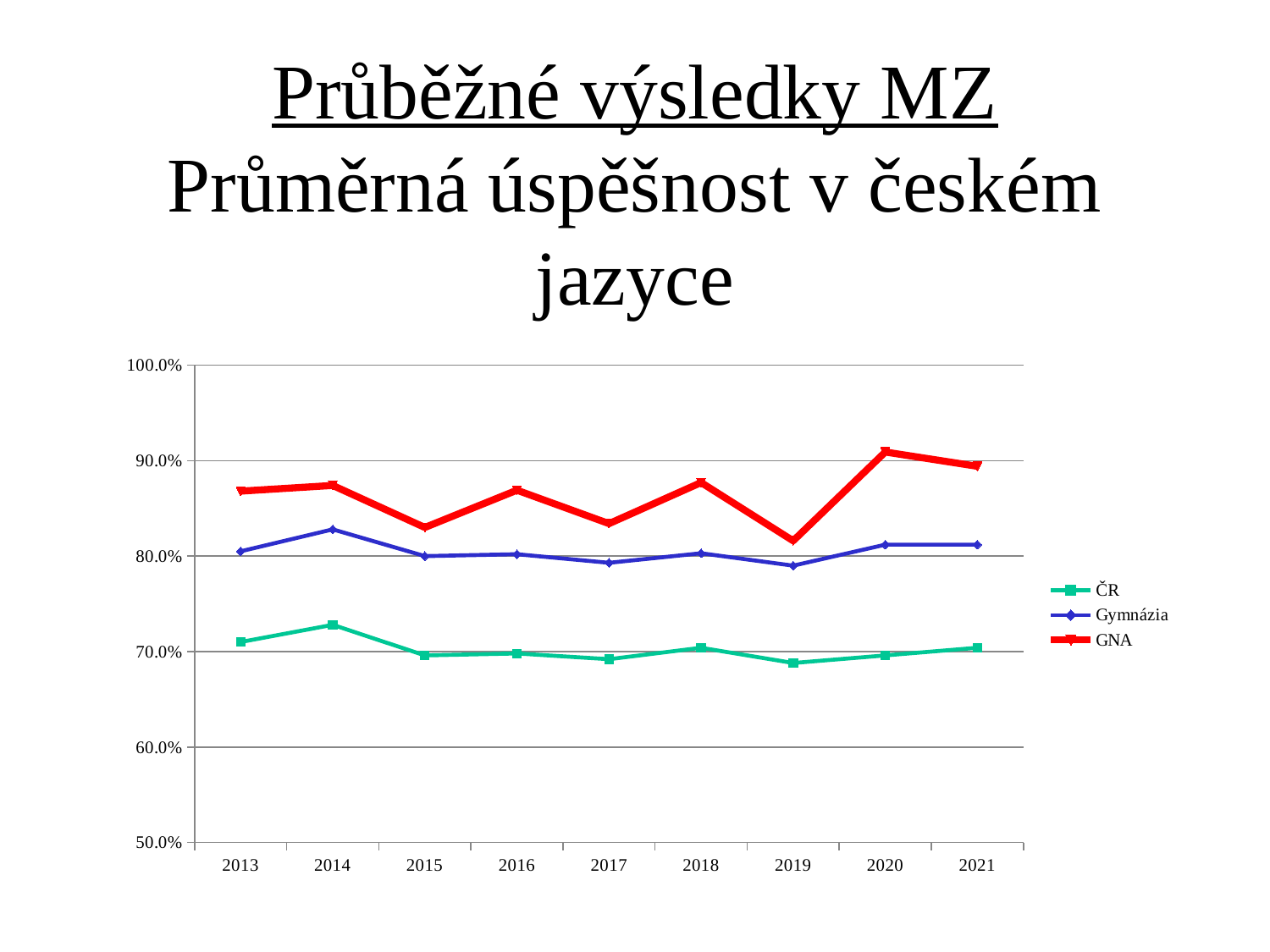
In which year does the Gymnázia series reach its highest value? 2014 What kind of chart is shown on the slide? line chart Does the GNA series rise or fall from 2019 to 2020? rise In which year does the GNA series reach its lowest value? 2019 How many series does the legend list? 3 In which year does the GNA series reach its highest value? 2020 Which series has the higher value in 2013, GNA or ČR? GNA Is the value for Gymnázia in 2014 greater or less than 80.0%? greater Which series is drawn with the red line? GNA Is the value for ČR in 2019 greater or less than 70.0%? less In which year does the ČR series reach its highest value? 2014 How many years are plotted along the x axis? 9